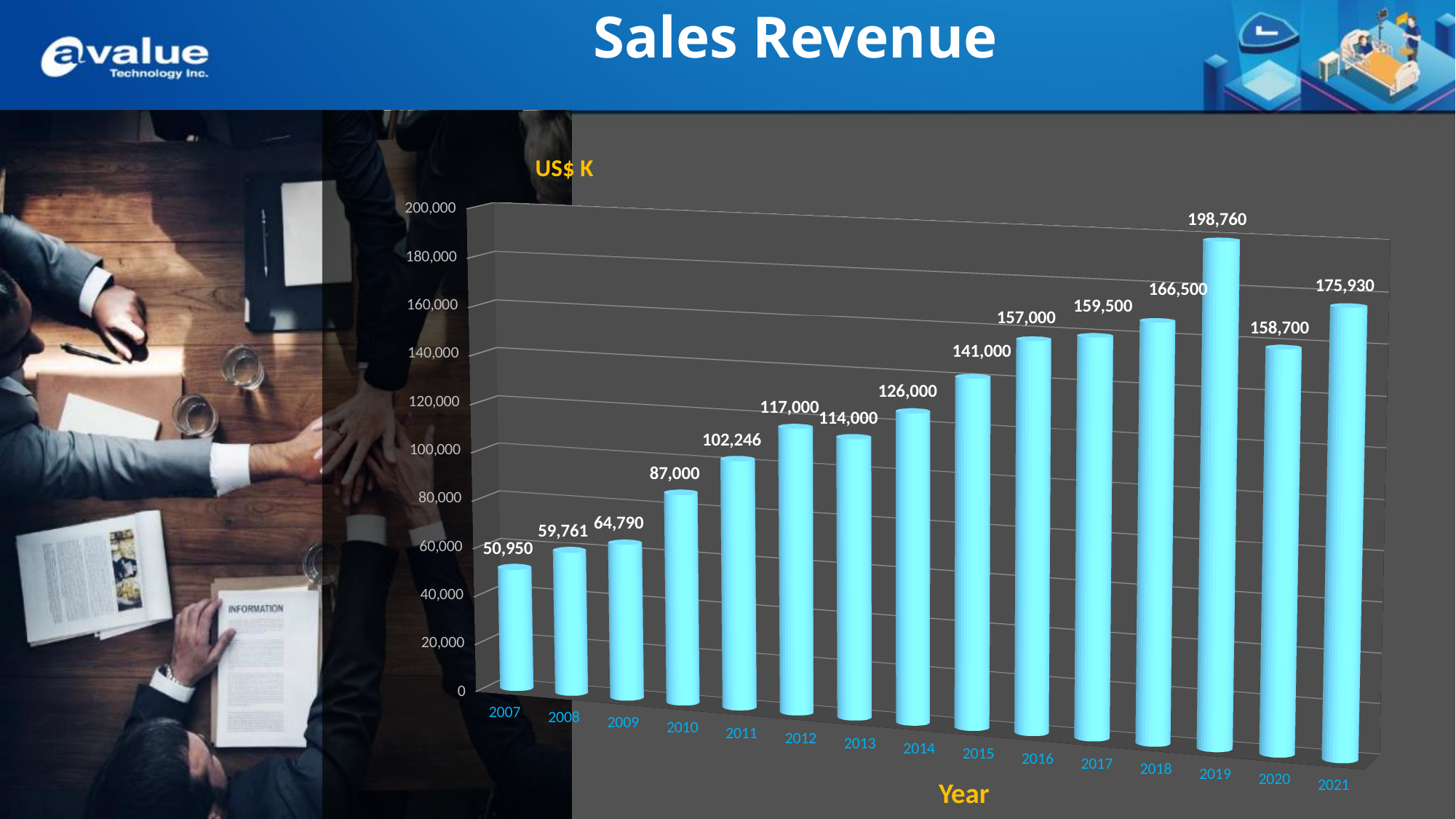
What kind of chart is shown on the slide? Bar chart What is the difference in sales revenue between 2021 and 2020? 17,230 Which year had the lowest sales revenue? 2007 What was the sales revenue in 2021? 175,930 Did sales revenue rise or fall from 2019 to 2020? Fall What was the sales revenue in 2007? 50,950 What unit is shown for the vertical axis of the chart? US$ K Which year had higher sales revenue, 2012 or 2013? 2012 Which year had the highest sales revenue? 2019 Is the value for 2016 greater or less than 140,000? greater How many years are shown on the chart? 15 What was the sales revenue in 2019? 198,760